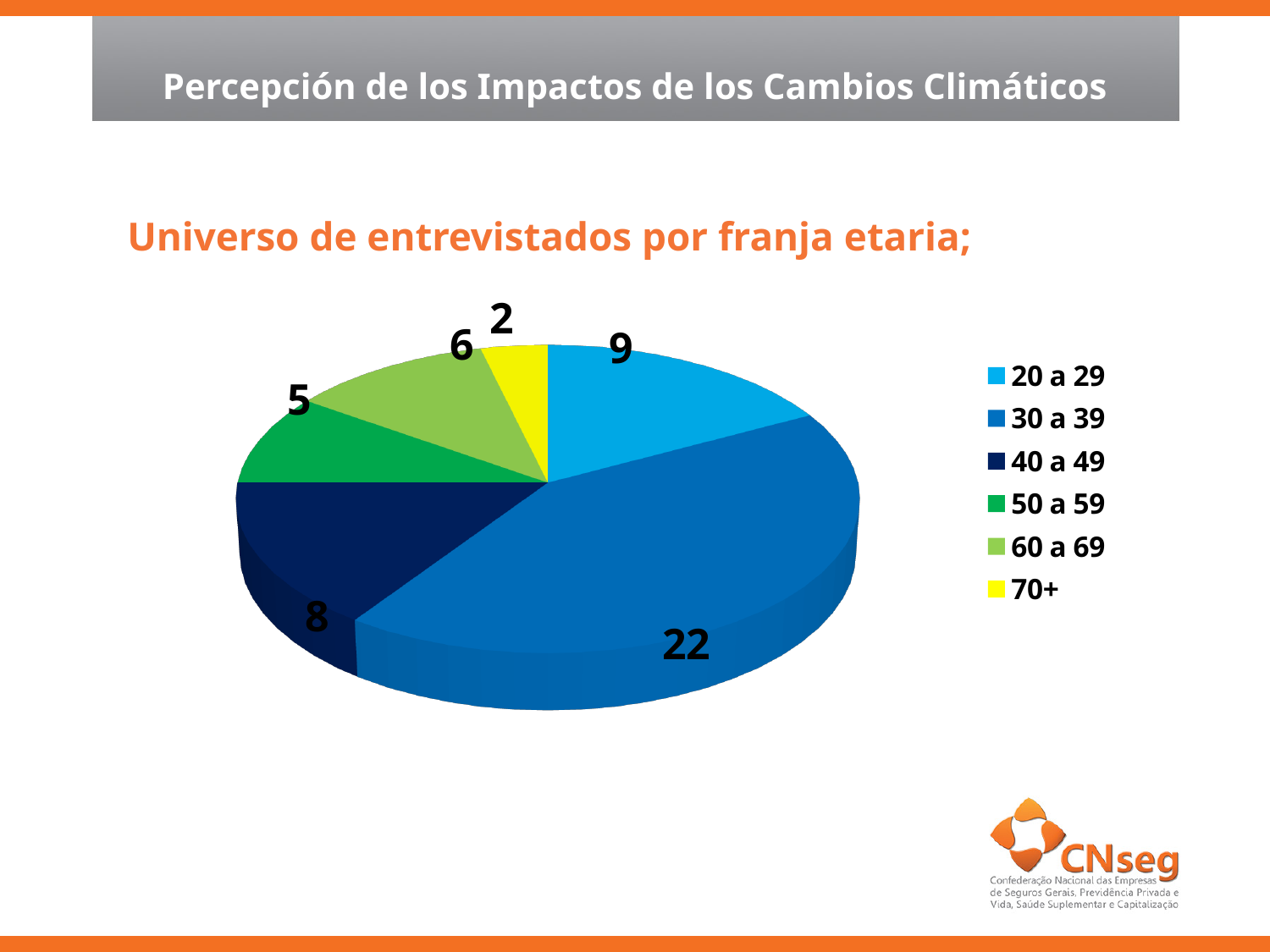
Which age group has the largest slice of the pie? 30 a 39 What is the total of all the slice values in the pie chart? 52 What colour is the 70+ slice in the pie chart? Yellow What value is shown for the 70+ slice? 2 What value is shown for the 30 a 39 slice? 22 What value is shown for the 20 a 29 slice? 9 Which age group has the smallest slice of the pie? 70+ What kind of chart is shown on the slide? Pie chart How many age groups are shown in the pie chart? 6 What is the difference between the values for 30 a 39 and 40 a 49? 14 Which is larger, the value for 60 a 69 or the value for 50 a 59? 60 a 69